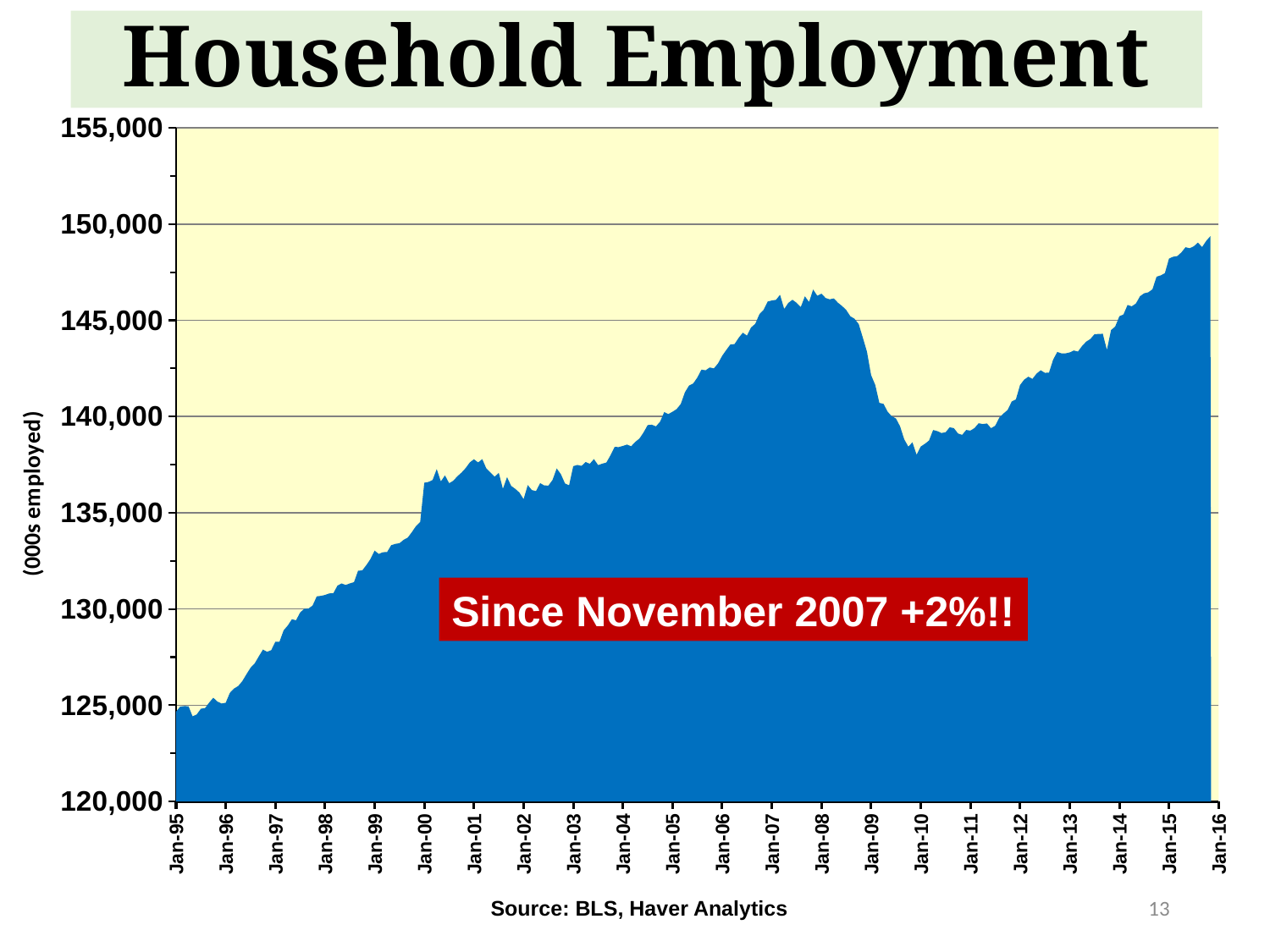
What is the title of the chart? Household Employment Is the value at Jan-13 greater or less than 140,000? greater Does household employment rise or fall overall from Jan-95 to Jan-16? Rise Which of Jan-08 and Jan-10 has the higher household employment? Jan-08 Is the value at Jan-03 greater or less than 135,000? greater Is the value at Jan-10 greater or less than 140,000? less Does household employment rise or fall between Jan-08 and Jan-10? Fall What kind of chart is shown on the slide? Area chart How many year labels are shown on the horizontal axis? 22 What is the label on the vertical axis? (000s employed)